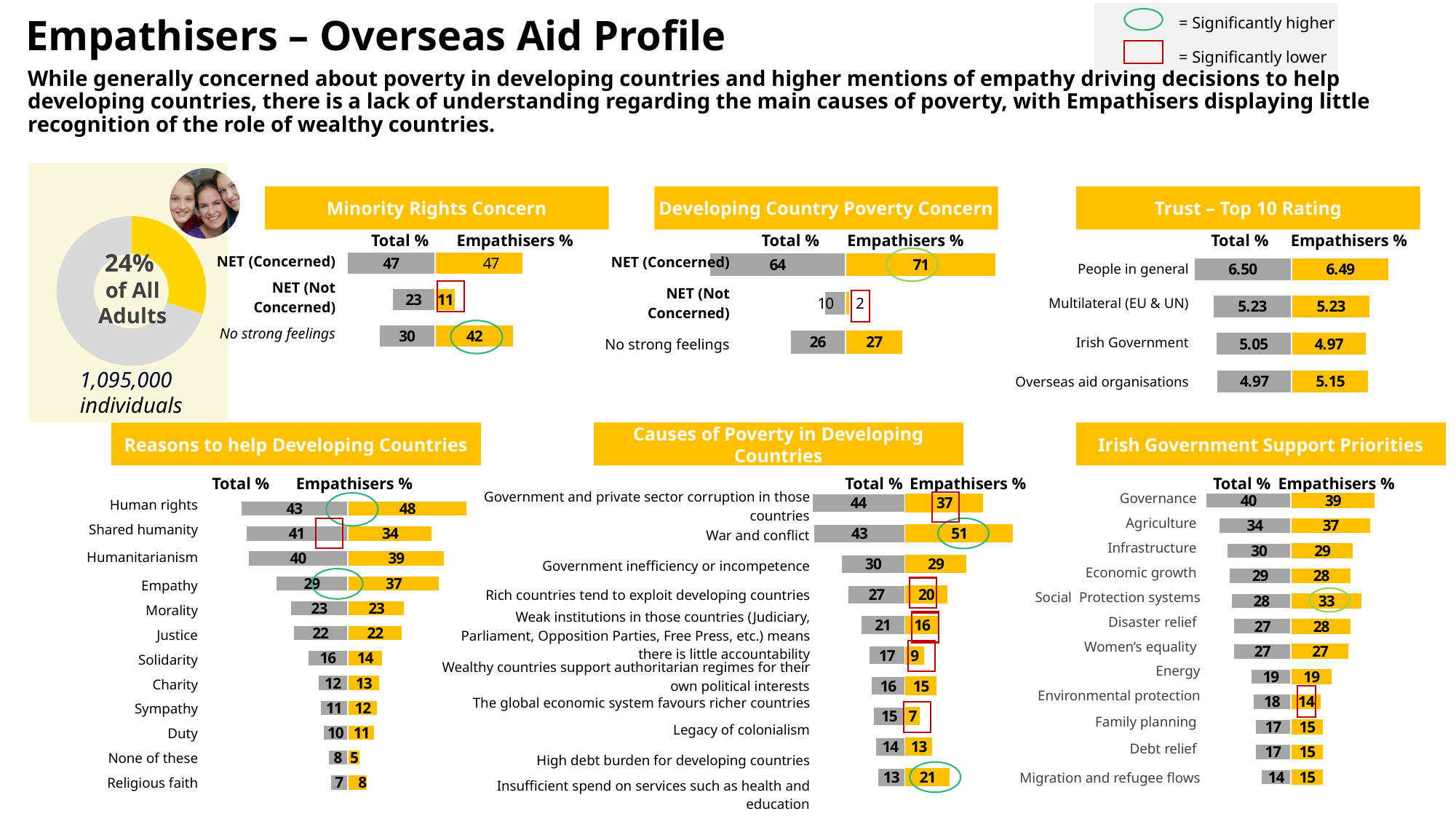
In the Trust – Top 10 Rating chart, what is the Total % value for Overseas aid organisations? 4.97 In the Developing Country Poverty Concern chart, what is the difference between the Empathisers % and the Total % for NET (Concerned)? 7 In the Trust – Top 10 Rating chart, which is larger for Irish Government, the Total % or the Empathisers % value? Total % In the Irish Government Support Priorities chart, which priority has the lowest Total %? Migration and refugee flows In the Irish Government Support Priorities chart, what is the Empathisers % for Social Protection systems? 33 In the Developing Country Poverty Concern chart, what is the Empathisers % for NET (Concerned)? 71 According to the donut chart on the left, what share of all adults are Empathisers? 24% In the Reasons to help Developing Countries chart, which reason has the highest Empathisers %? Human rights In the Minority Rights Concern chart, what is the Empathisers % for NET (Concerned)? 47 In the Reasons to help Developing Countries chart, what is the Empathisers % for Empathy? 37 How many reasons are listed in the Reasons to help Developing Countries chart? 12 In the Minority Rights Concern chart, what is the Total % for No strong feelings? 30